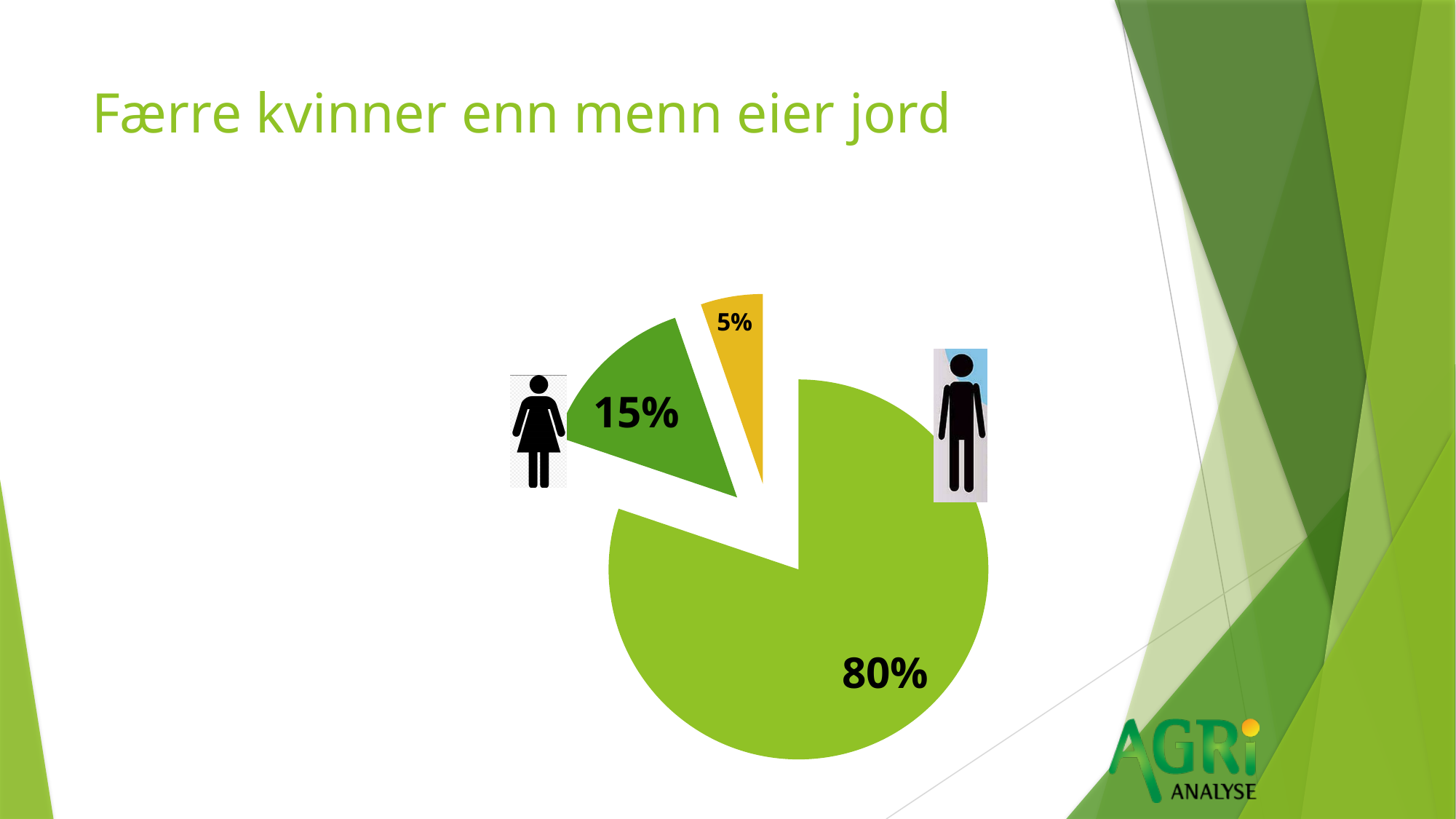
Which slice of the pie chart is the largest? 80% (man icon) What percentage is shown on the slice marked with the man icon? 80% How many slices does the pie chart have? 3 What percentage is shown on the yellow slice of the pie chart? 5% What percentage is shown on the slice marked with the woman icon? 15% What is the difference in percentage points between the slice with the woman icon and the yellow slice? 10 What is the title of the slide containing the pie chart? Færre kvinner enn menn eier jord What is the difference in percentage points between the slice with the man icon and the slice with the woman icon? 65 What colour is the largest slice of the pie chart? light green What kind of chart is shown on the slide? pie chart Which slice of the pie chart is the smallest? 5% (yellow slice) Which is larger: the slice with the woman icon or the yellow slice? the slice with the woman icon